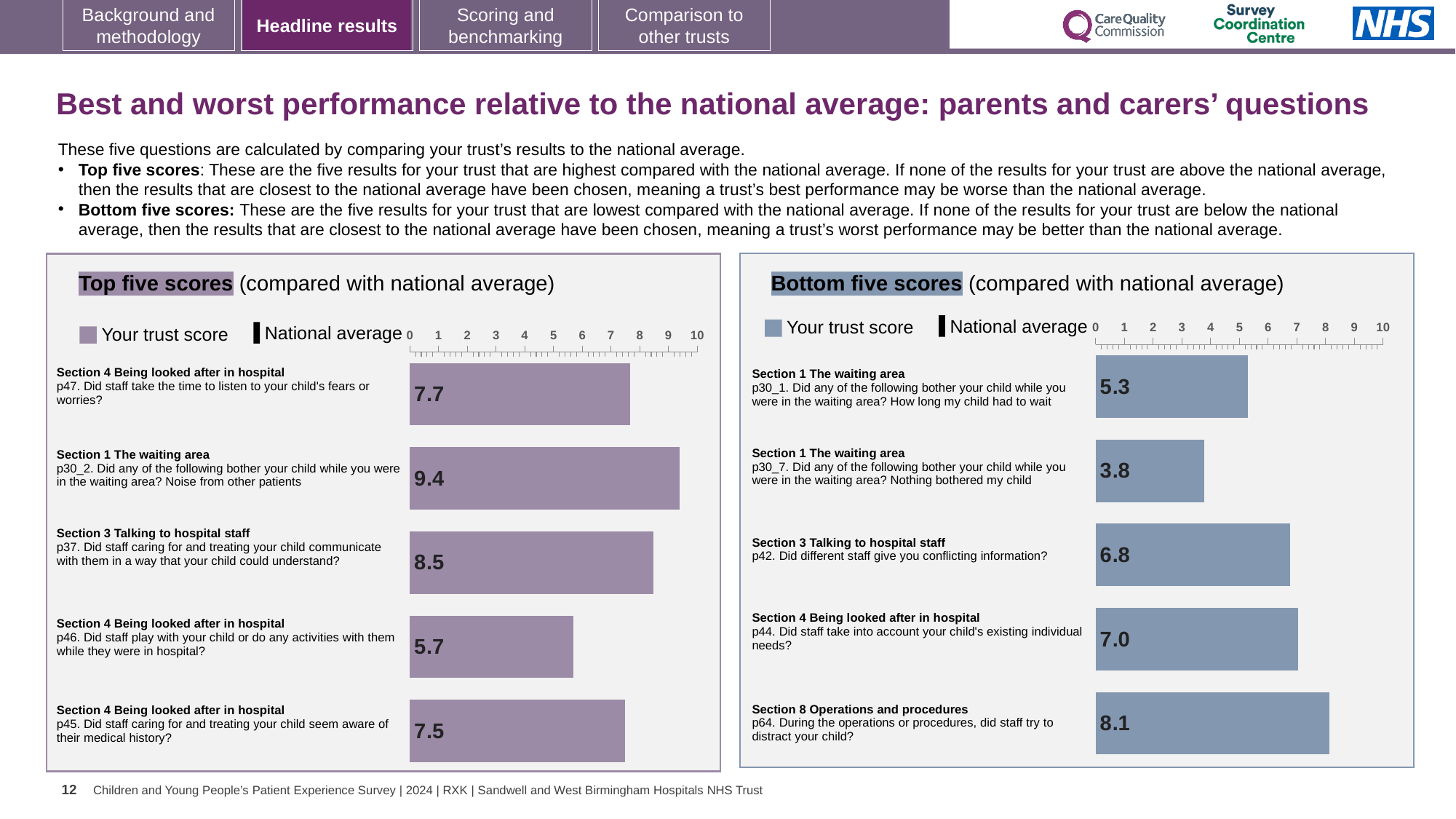
In the Top five scores chart, what is the trust score for p46 (did staff play with your child or do any activities with them)? 5.7 In the Top five scores chart, what is the trust score for p30_2 (noise from other patients in the waiting area)? 9.4 How many questions are shown in the Top five scores chart? 5 In the Bottom five scores chart, what is the trust score for p30_7 (nothing bothered my child in the waiting area)? 3.8 In the Top five scores chart, what is the difference between the trust scores for p47 and p45? 0.2 What is the maximum value shown on the axis of the Top five scores chart? 10 What type of chart is used in the Bottom five scores panel? Bar chart In the Bottom five scores chart, what is the difference between the trust scores for p64 and p30_1? 2.8 In the Bottom five scores chart, which has the larger trust score: p42 or p44? p44 In the Bottom five scores chart, what is the trust score for p64 (did staff try to distract your child during operations or procedures)? 8.1 In the Bottom five scores chart, which question has the lowest trust score? p30_7. Did any of the following bother your child while you were in the waiting area? Nothing bothered my child In the Top five scores chart, which question has the highest trust score? p30_2. Did any of the following bother your child while you were in the waiting area? Noise from other patients